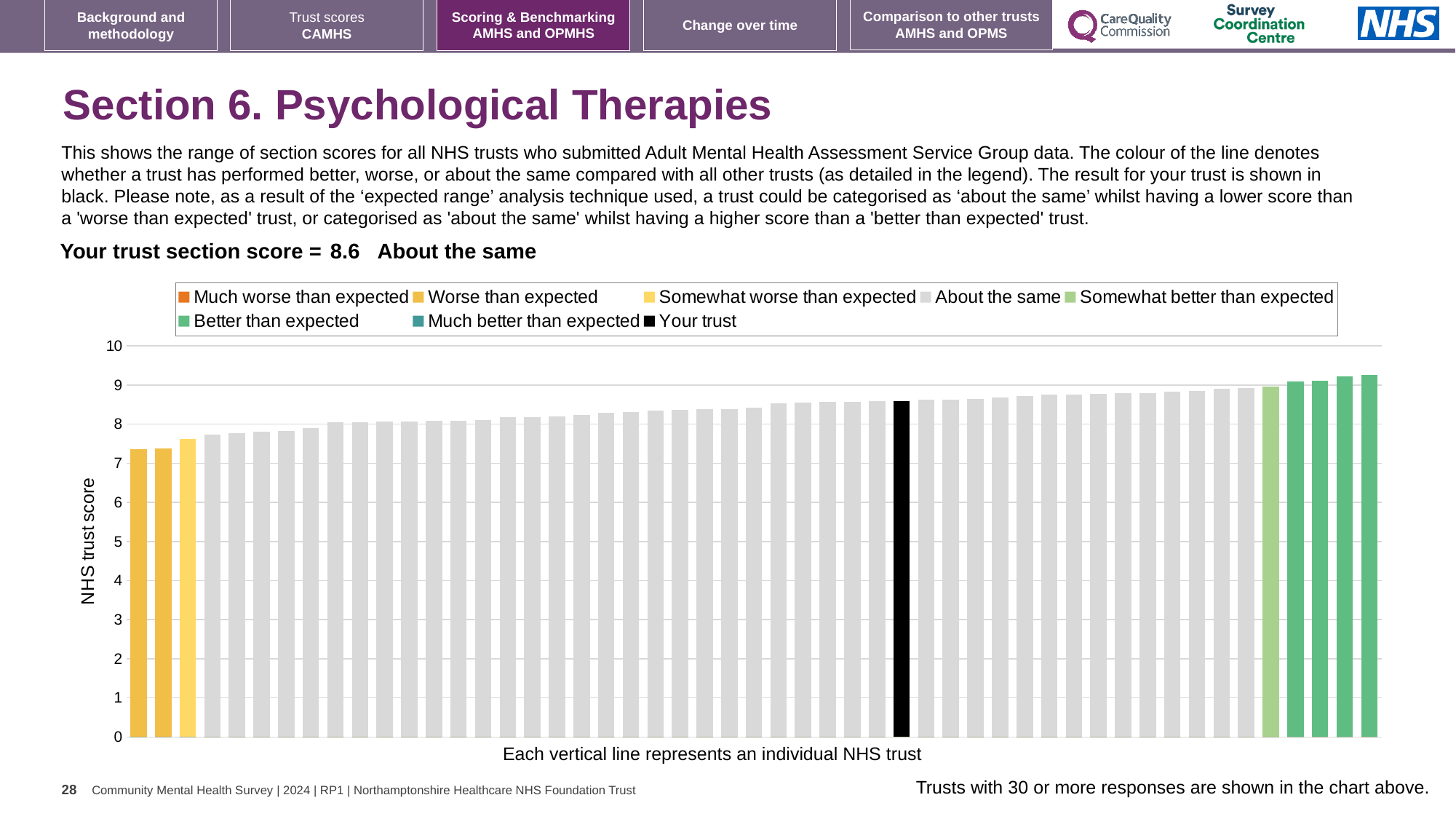
What is the label on the vertical axis of the chart? NHS trust score What is your trust's section score for Psychological Therapies? 8.6 What kind of chart is shown on the slide? Bar chart Do the bar values rise or fall from left to right along the x axis? Rise How many bars are shown in the 'Better than expected' colour? 4 Which category is your trust's section score placed in? About the same Is the value for the lowest bar on the chart greater or less than 8? less Is the value for the tallest bar on the chart greater or less than 9? greater How many entries does the chart legend list? 8 Is the value for the black 'Your trust' bar greater or less than 8? greater Which legend category does the tallest bar on the chart belong to? Better than expected Which is larger: the value for the black 'Your trust' bar or the value for the leftmost bar? Your trust